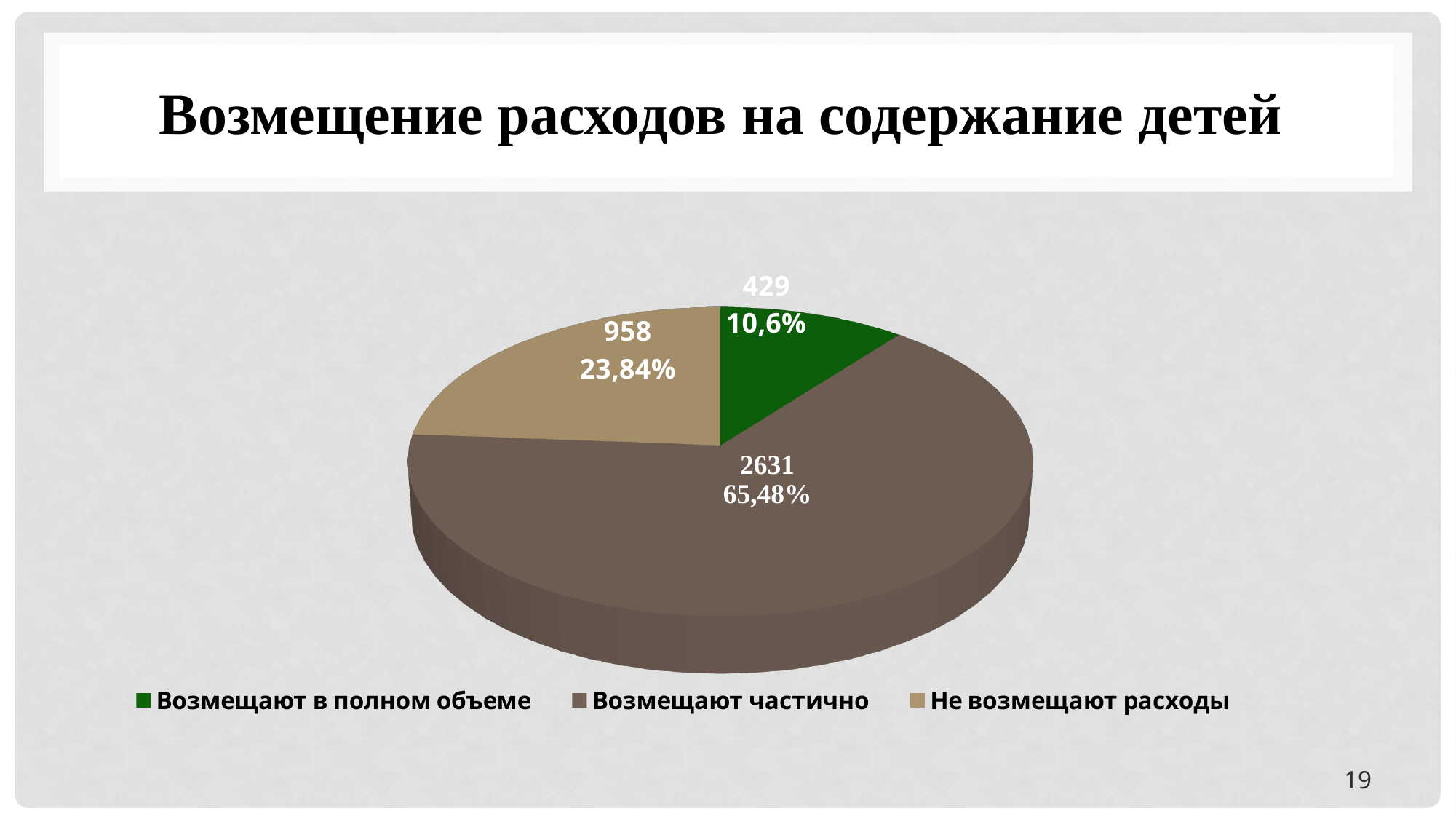
What share of the pie does "Возмещают в полном объеме" take? 10,6% What share of the pie does "Не возмещают расходы" take? 23,84% What is the difference between the values for "Не возмещают расходы" and "Возмещают в полном объеме"? 529 Which category has the smallest slice? Возмещают в полном объеме What kind of chart is shown on the slide? pie chart What is the value for "Возмещают частично"? 2631 What is the value for "Не возмещают расходы"? 958 What is the title of the slide? Возмещение расходов на содержание детей What share of the pie does "Возмещают частично" take? 65,48% Which category has the largest slice? Возмещают частично How many categories does the pie chart have? 3 What is the value for "Возмещают в полном объеме"? 429